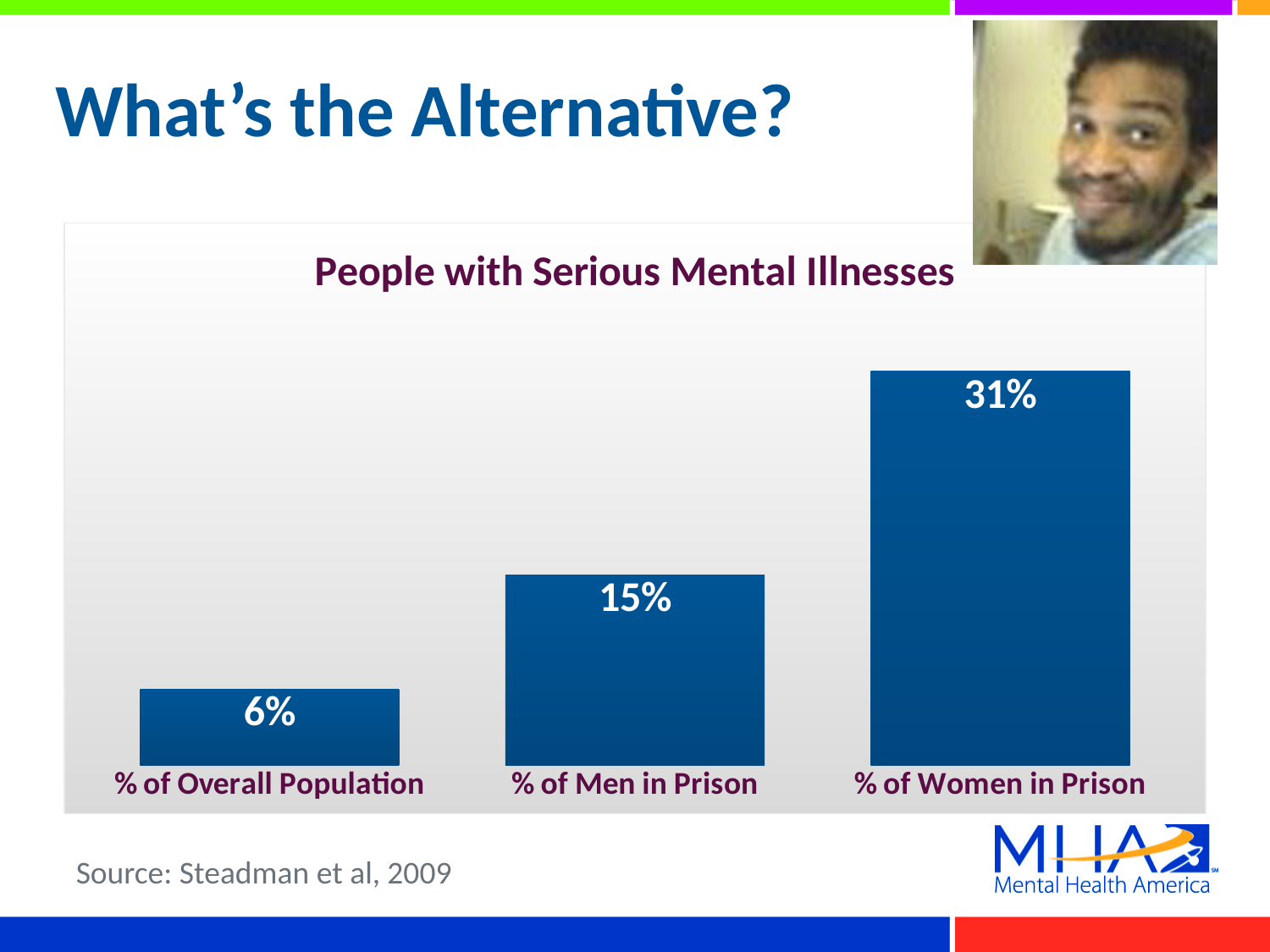
What kind of chart is shown on the slide? Bar chart Do the values rise or fall from left to right across the categories? Rise What is the value for % of Overall Population? 6% What is the title of the chart? People with Serious Mental Illnesses Which category has the lowest value? % of Overall Population What is the value for % of Men in Prison? 15% How many categories are shown in the chart? 3 What is the difference between the value for % of Women in Prison and the value for % of Men in Prison? 16% Which category has the highest value? % of Women in Prison What is the difference between the value for % of Men in Prison and the value for % of Overall Population? 9% Which is larger, the value for % of Men in Prison or the value for % of Overall Population? % of Men in Prison What is the value for % of Women in Prison? 31%